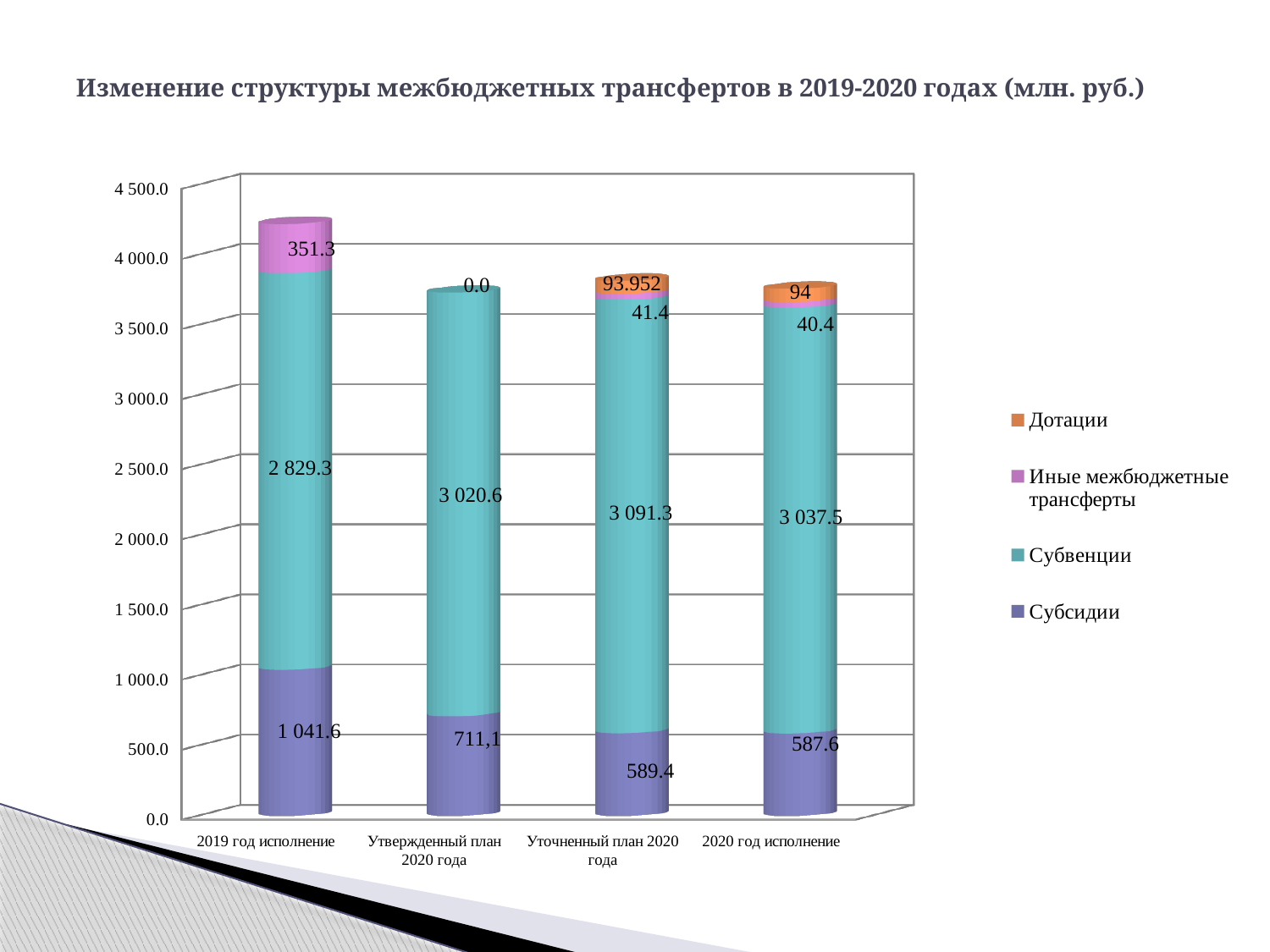
What is the value of Дотации for Уточненный план 2020 года? 93.952 Which is larger: Субвенции for Утвержденный план 2020 года or Субвенции for 2020 год исполнение? 2020 год исполнение What is the value of Иные межбюджетные трансферты for 2020 год исполнение? 40.4 How many series does the legend list? 4 What is the value of Субвенции for 2019 год исполнение? 2 829.3 Which category has the highest value for Субвенции? Уточненный план 2020 года How many categories are shown on the x axis? 4 What is the difference between the Субсидии values for 2019 год исполнение and 2020 год исполнение? 454.0 What is the value of Субсидии for Утвержденный план 2020 года? 711,1 What is the total of the stacked bar for 2020 год исполнение? 3 759.5 What kind of chart is shown on the slide? Stacked bar chart Which category has the lowest value for Субсидии? 2020 год исполнение